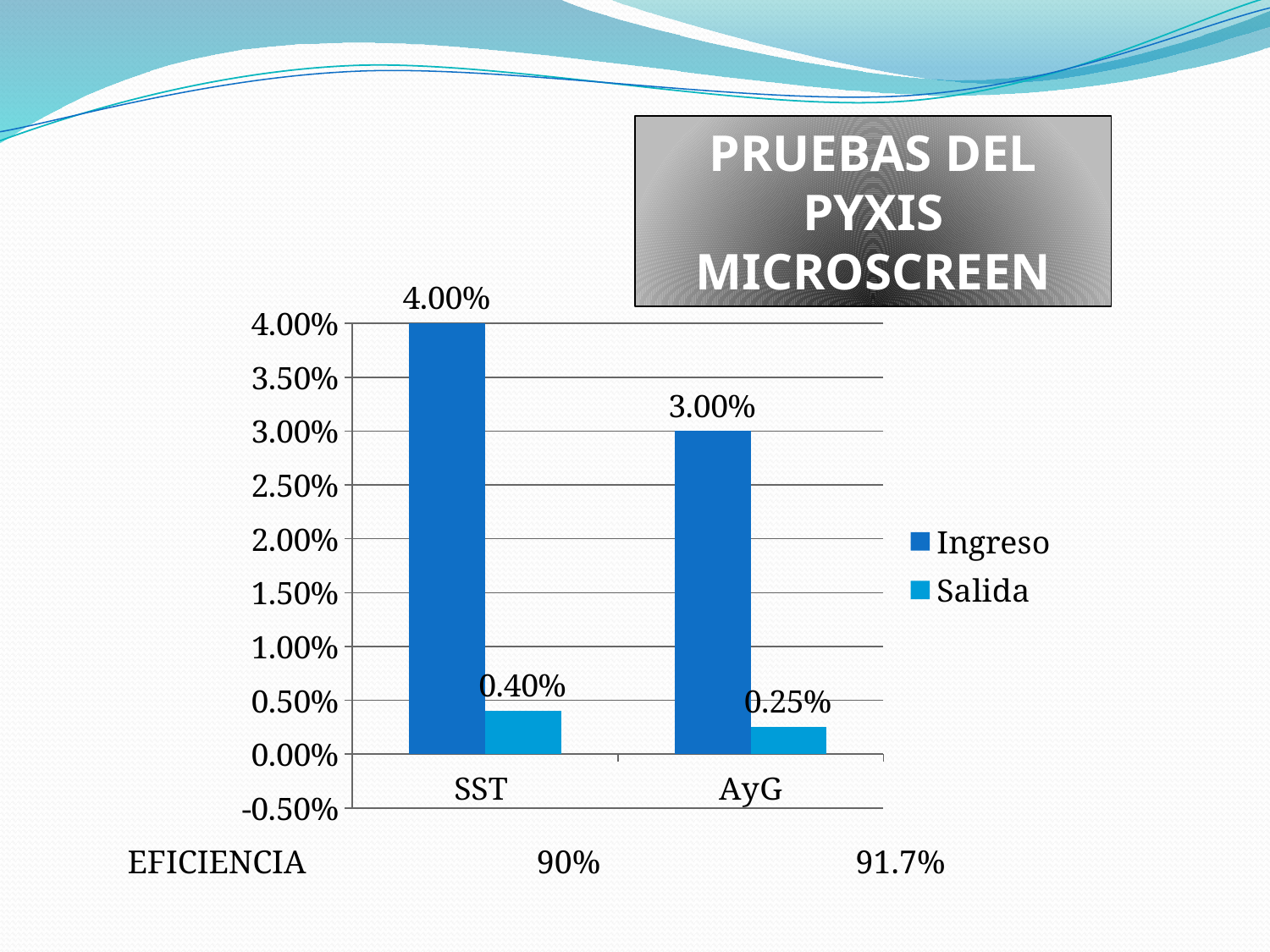
How many categories are shown on the x axis? 2 What is the Ingreso value for SST? 4.00% Which is larger, the Ingreso value for SST or the Ingreso value for AyG? SST What kind of chart is shown on the slide? bar chart Is the Ingreso value for AyG greater or less than 2.50%? greater What is the Salida value for SST? 0.40% How many series does the legend list? 2 What is the difference between the Ingreso and Salida values for SST? 3.60% What is the Ingreso value for AyG? 3.00% Which category has the lowest Salida value? AyG Which category has the highest Ingreso value? SST What is the Salida value for AyG? 0.25%